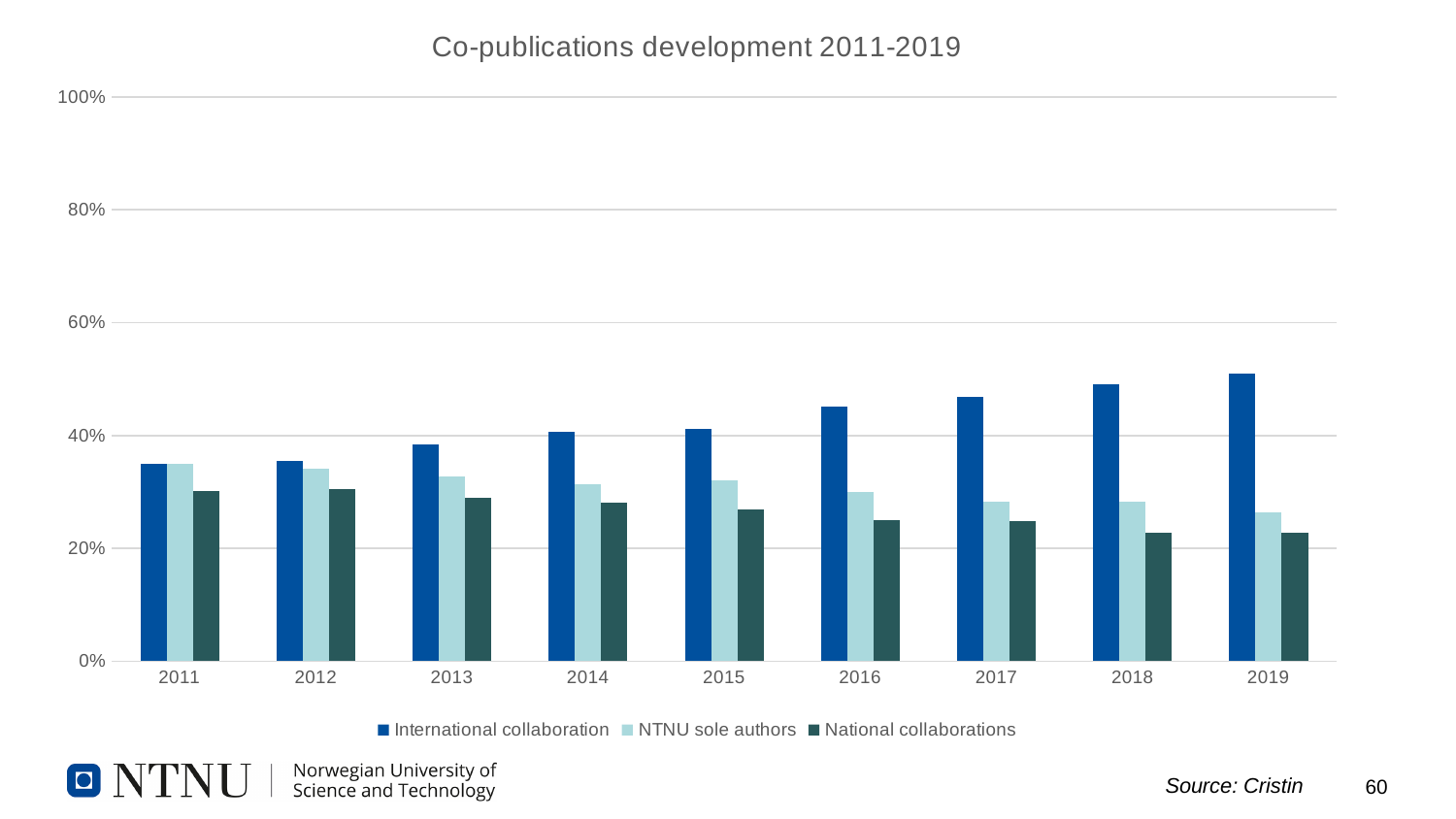
Is the value for International collaboration in 2019 greater or less than 40%? greater What is the title of the chart? Co-publications development 2011-2019 Is the value for National collaborations in 2019 greater or less than 40%? less How many series does the legend list? 3 Does the International collaboration series rise or fall from 2011 to 2019? Rise How many years are shown on the x axis? 9 In 2019, which is larger: International collaboration or National collaborations? International collaboration Which year has the lowest value for NTNU sole authors? 2019 What kind of chart is shown on the slide? Bar chart Which year has the highest value for International collaboration? 2019 Is the value for International collaboration in 2019 greater or less than 60%? less In 2016, which is larger: NTNU sole authors or National collaborations? NTNU sole authors